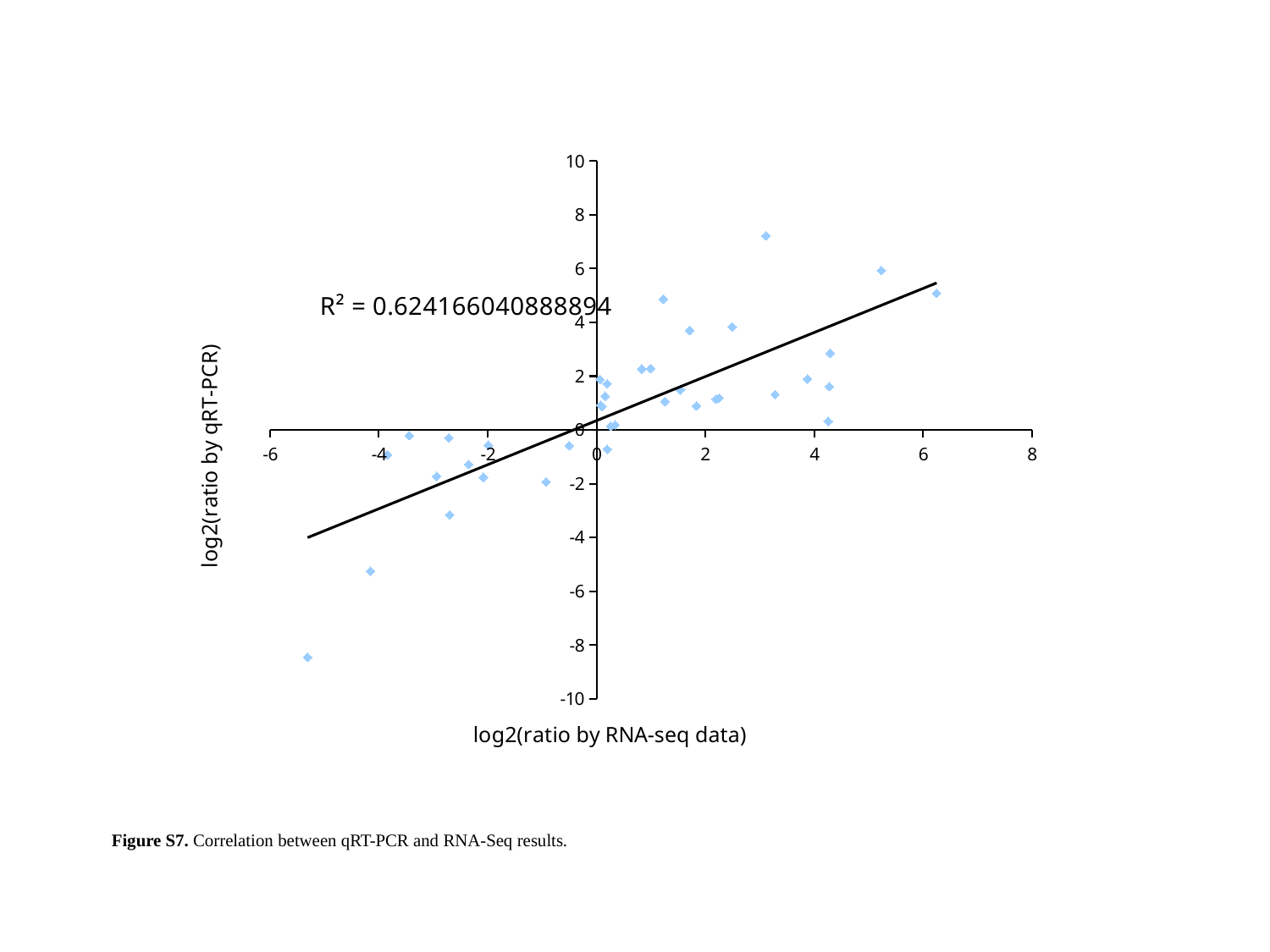
As the log2(ratio by RNA-seq data) increases along the x axis, does the fitted trendline rise or fall? rise Is the y value of the lowest point on the chart greater or less than -8? less What is the label of the x axis? log2(ratio by RNA-seq data) What kind of chart is shown on the slide? scatter chart Are there more points plotted with positive x values or with negative x values? positive x values What R² value is printed on the chart? R² = 0.624166040888894 Is the value of the trendline at x = 6 greater or less than 4? greater What is the label of the y axis? log2(ratio by qRT-PCR) Is the y value of the highest point on the chart greater or less than 6? greater